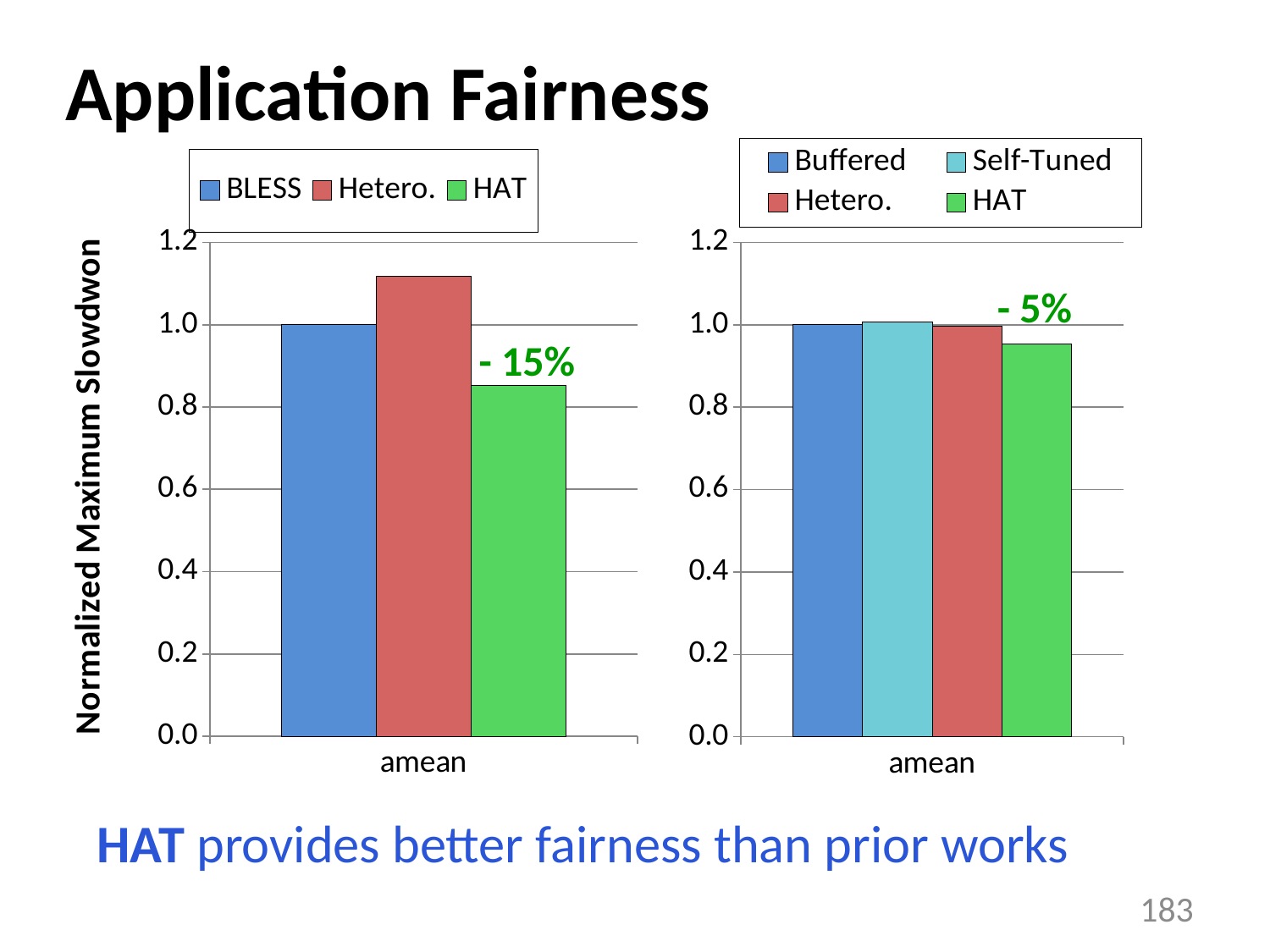
In the left chart, is the value for Hetero. greater or less than 1.0? greater In the left chart, is the value for HAT greater or less than 1.0? less How many series does the legend of the right chart list? 4 What kind of chart is the left chart? bar chart What percentage annotation is printed next to the HAT bar in the left chart? - 15% In the left chart, which series has the lowest normalized maximum slowdown? HAT How many categories are shown on the x axis of the right chart? 1 In the left chart, which is larger, the value for BLESS or the value for HAT? BLESS In the right chart, is the value for HAT greater or less than 1.0? less How many series does the legend of the left chart list? 3 In the right chart, which series has the lowest normalized maximum slowdown? HAT In the left chart, which series has the highest normalized maximum slowdown? Hetero.